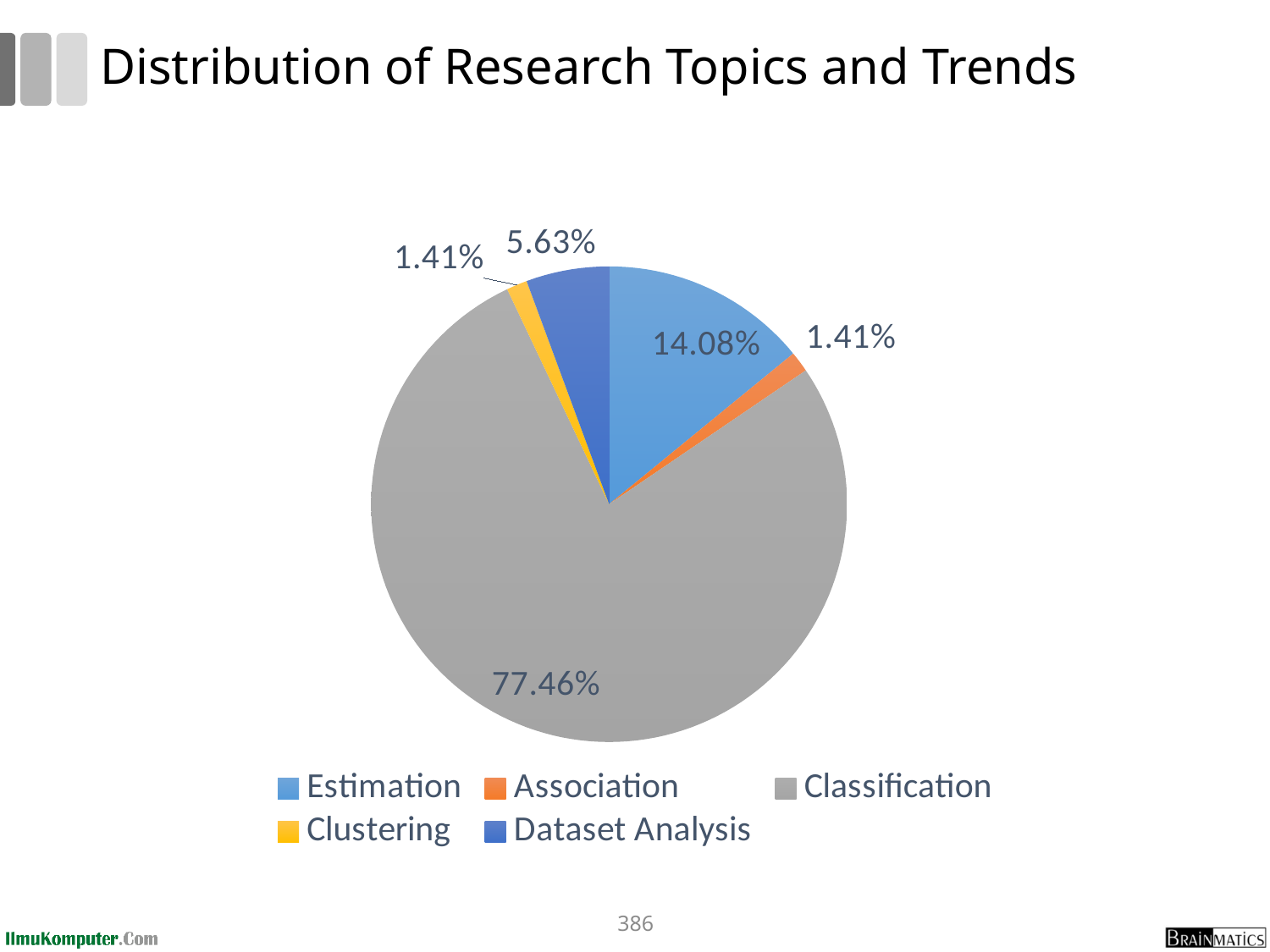
What share of the pie does Association represent? 1.41% What is the difference in percentage points between the Estimation slice and the Dataset Analysis slice? 8.45 What share of the pie does Dataset Analysis represent? 5.63% How many categories does the legend list? 5 What share of the pie does Clustering represent? 1.41% What is the difference in percentage points between the Classification slice and the Estimation slice? 63.38 Which category has the largest slice of the pie? Classification What is the title of the slide containing the chart? Distribution of Research Topics and Trends What type of chart is shown on the slide? pie chart What share of the pie does Estimation represent? 14.08% What share of the pie does Classification represent? 77.46% Which is larger, the slice for Estimation or the slice for Dataset Analysis? Estimation